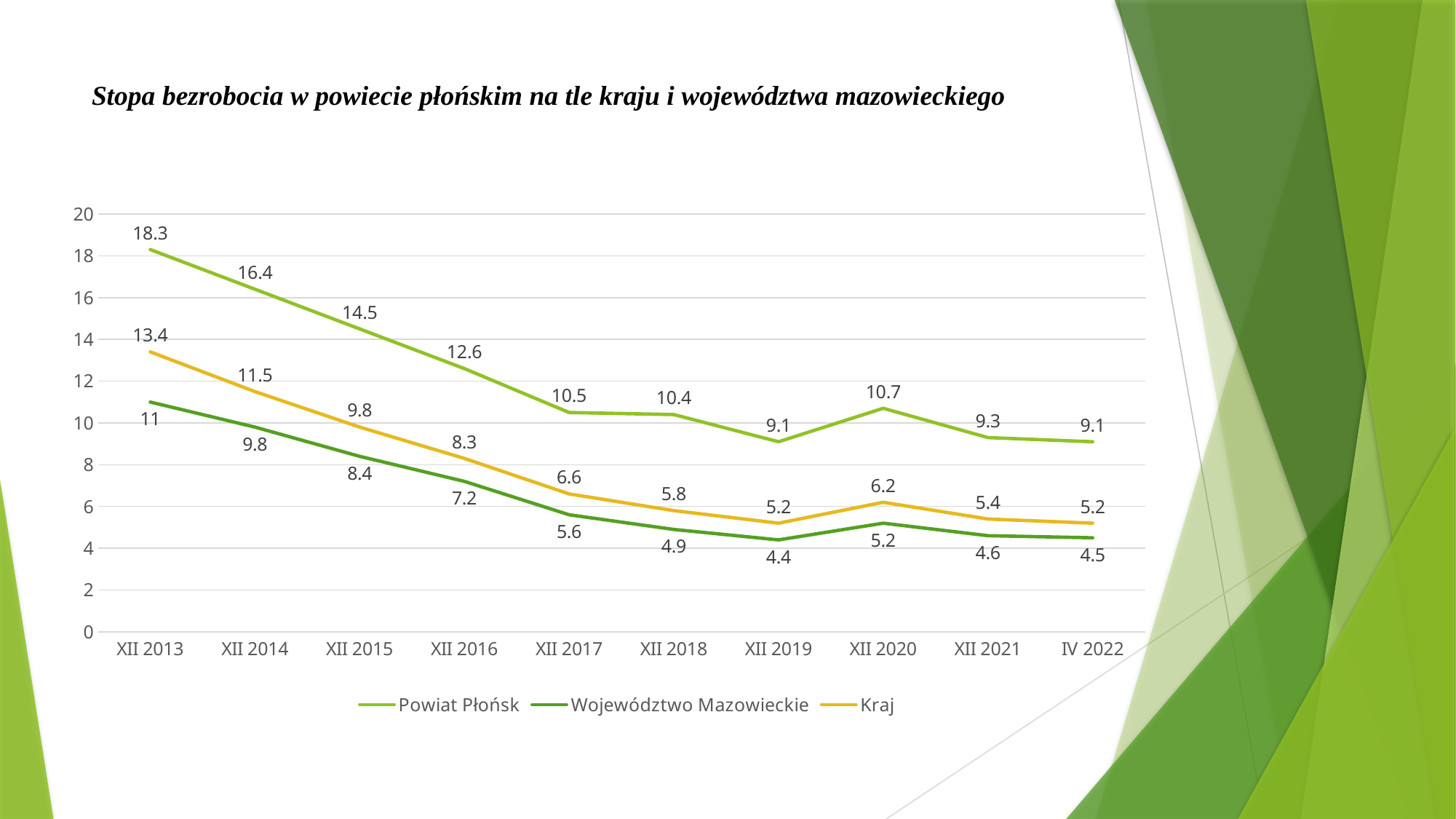
What is the difference between the Powiat Płońsk value and the Kraj value in XII 2020? 4.5 In which period is the value for Województwo Mazowieckie the lowest? XII 2019 What is the value for Kraj in XII 2017? 6.6 Which series has the larger value in IV 2022, Kraj or Województwo Mazowieckie? Kraj What is the title of the chart? Stopa bezrobocia w powiecie płońskim na tle kraju i województwa mazowieckiego In which period is the value for Powiat Płońsk the highest? XII 2013 Does the value for Powiat Płońsk generally rise or fall from XII 2013 to IV 2022? fall How many time points are plotted along the x axis? 10 What is the value for Województwo Mazowieckie in XII 2019? 4.4 How many series does the legend list? 3 What is the value for Powiat Płońsk in XII 2013? 18.3 What type of chart is shown on the slide? line chart